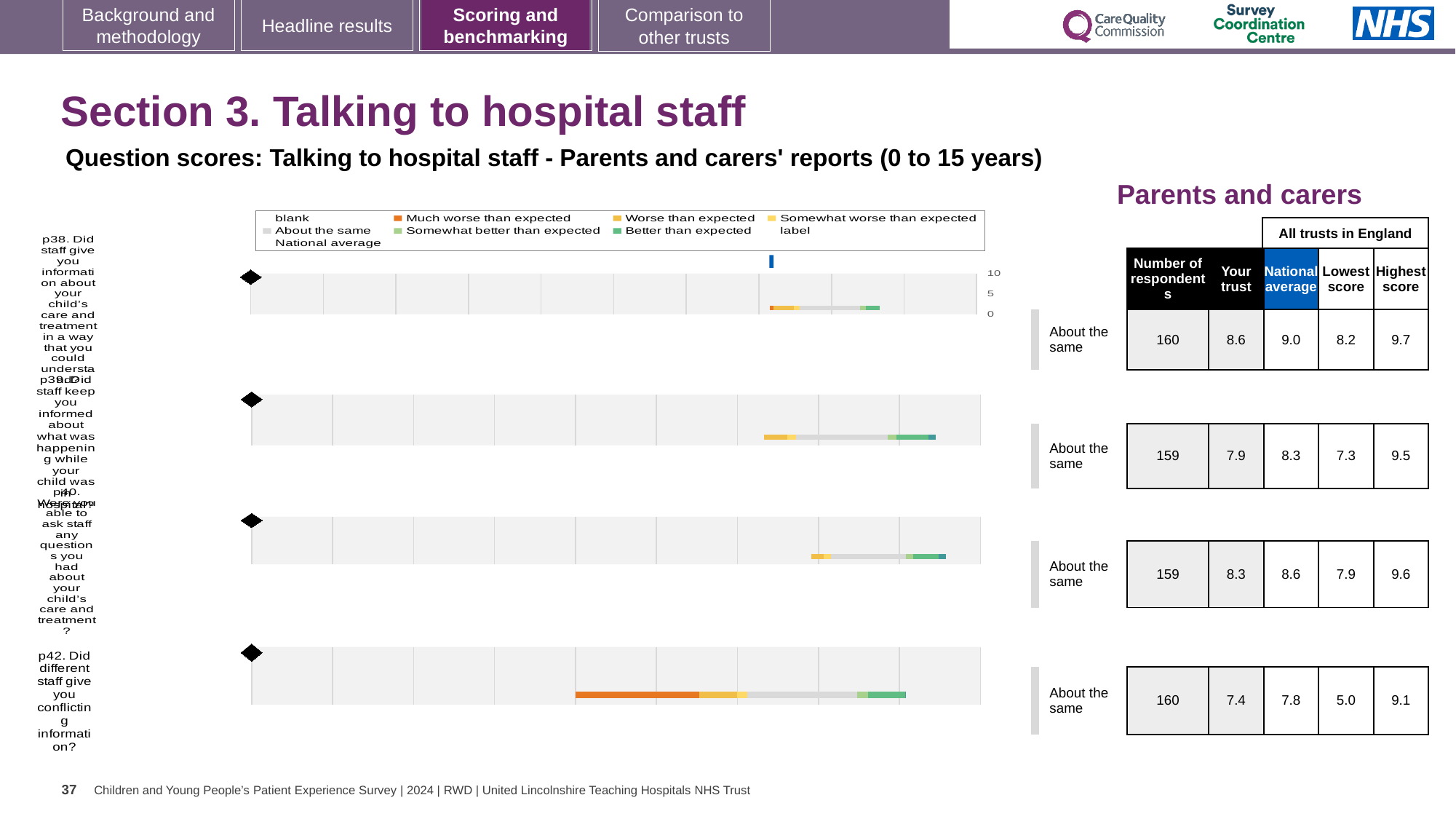
What is the highest score among all trusts in England for question p40 (being able to ask staff questions)? 9.6 For question p38 (staff giving information about your child's care and treatment), what is the 'Your trust' score? 8.6 What kind of chart is used to show the question scores on this slide? bar chart How many survey questions (charts) are shown on the slide? 4 How many respondents are listed for question p39 (staff keeping you informed about what was happening)? 159 What is the lowest score among all trusts in England for question p42? 5.0 For question p42 (different staff giving conflicting information), what is the national average score? 7.8 Which question has the lowest 'Your trust' score? p42 For question p38, which is larger: the 'Your trust' score or the national average? National average Which question has the highest 'Your trust' score? p38 What benchmark category label is shown next to each of the four charts? About the same For question p42, what is the difference between the highest score and the lowest score among all trusts in England? 4.1